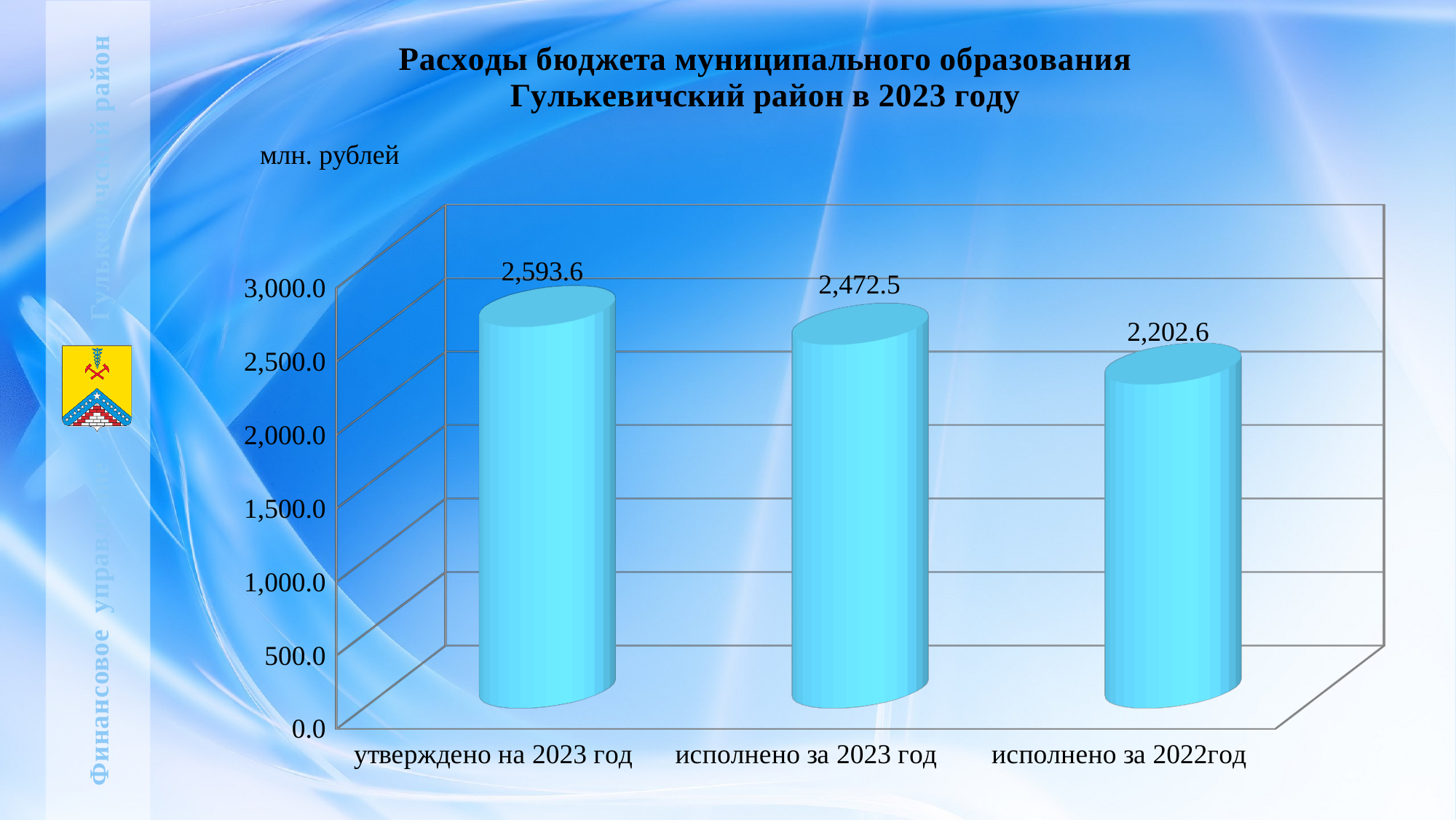
What is the value for "утверждено на 2023 год"? 2,593.6 What is the difference between the values for "исполнено за 2023 год" and "исполнено за 2022год"? 269.9 Which category has the lowest value? исполнено за 2022год What is the value for "исполнено за 2022год"? 2,202.6 What kind of chart is shown on the slide? bar chart Which category has the highest value? утверждено на 2023 год Do the values rise or fall from left to right along the x axis? fall What is the difference between the values for "утверждено на 2023 год" and "исполнено за 2023 год"? 121.1 Which is larger: the value for "исполнено за 2023 год" or for "исполнено за 2022год"? исполнено за 2023 год What is the value for "исполнено за 2023 год"? 2,472.5 Is the value for "исполнено за 2022год" greater or less than 2,500.0? less How many categories are shown on the chart? 3